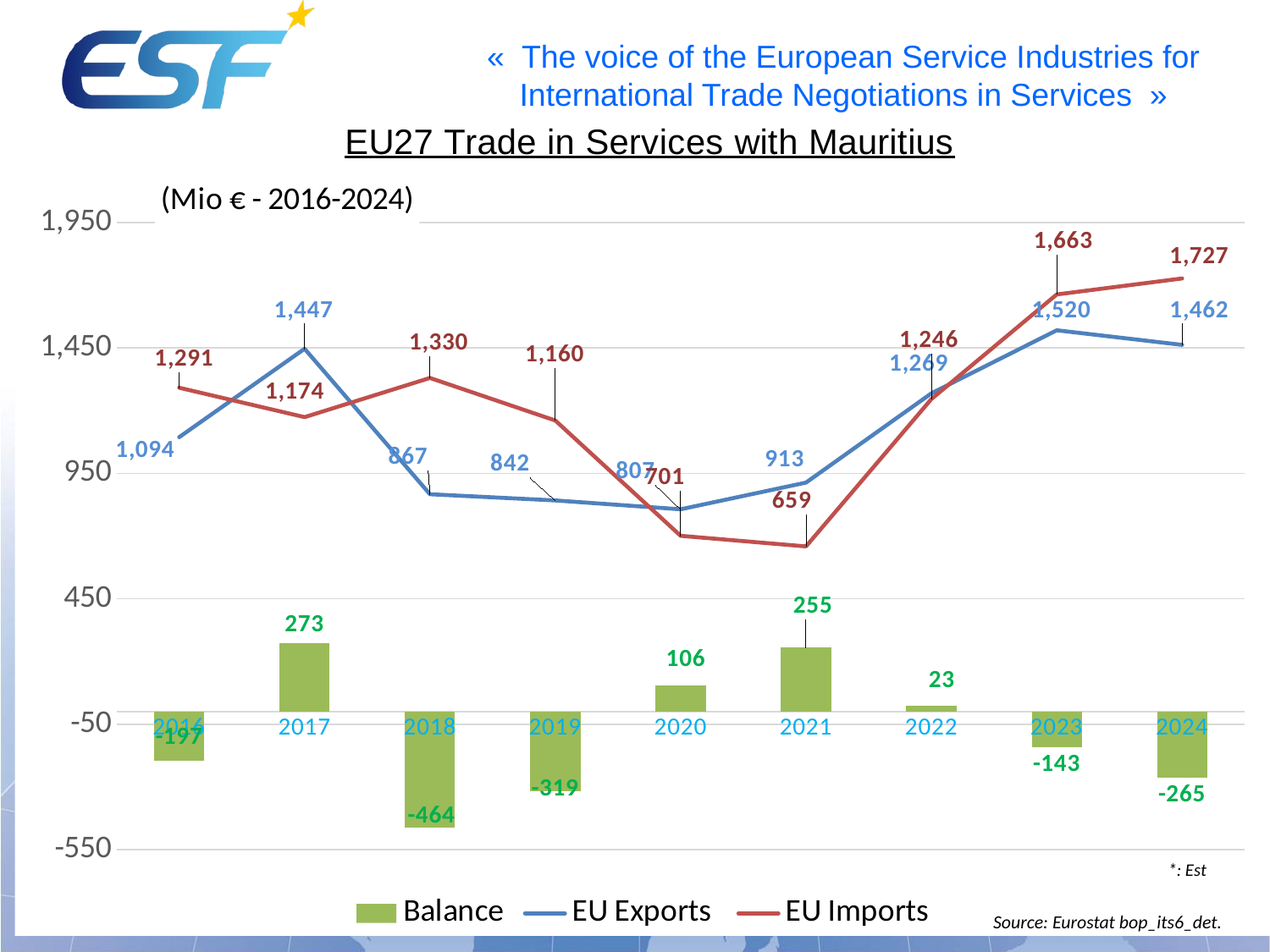
What is the value of EU Imports in 2021? 659 Which is larger in 2019, EU Exports or EU Imports? EU Imports In which year are EU Exports lowest? 2020 What is the value of EU Exports in 2017? 1,447 In which year are EU Imports highest? 2024 What is the Balance value for 2018? -464 What kind of chart is this? Combined bar and line chart What is the difference between EU Imports in 2024 and in 2023? 64 How many years are shown on the x axis? 9 How many series does the legend list? 3 Do EU Imports rise or fall from 2021 to 2024? Rise In which year is the Balance highest? 2017